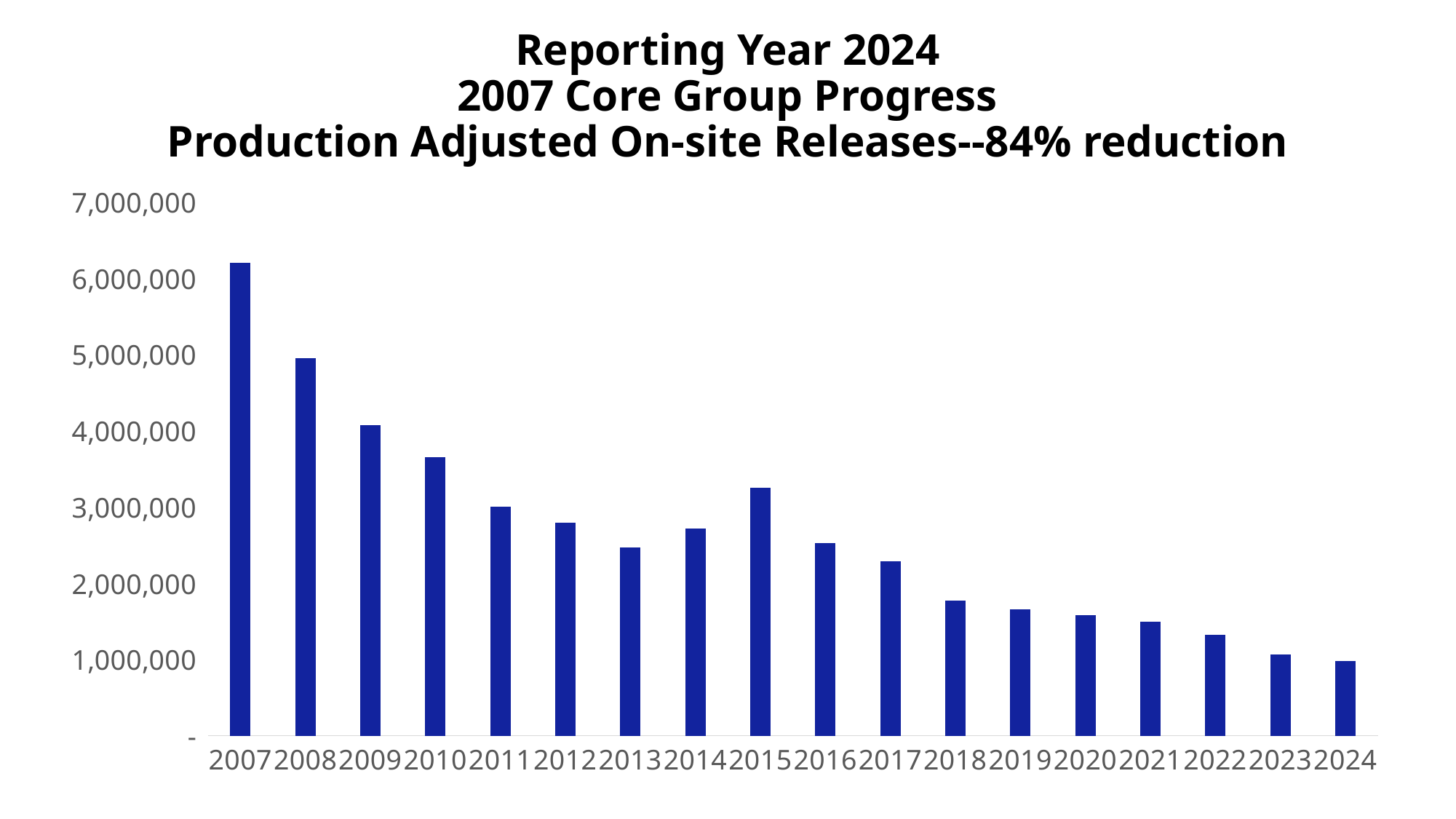
What percentage reduction does the chart title state? 84% Overall, do the values rise or fall from 2007 to 2024? fall Which is larger, the value for 2015 or the value for 2014? 2015 What kind of chart is shown on the slide? bar chart Is the value for 2010 greater or less than 4,000,000? less Which year has the lowest production adjusted on-site releases? 2024 Is the value for 2018 greater or less than 2,000,000? less Is the value for 2015 greater or less than 3,000,000? greater How many years are plotted on the x axis? 18 Which is larger, the value for 2013 or the value for 2012? 2012 Which year has the highest production adjusted on-site releases? 2007